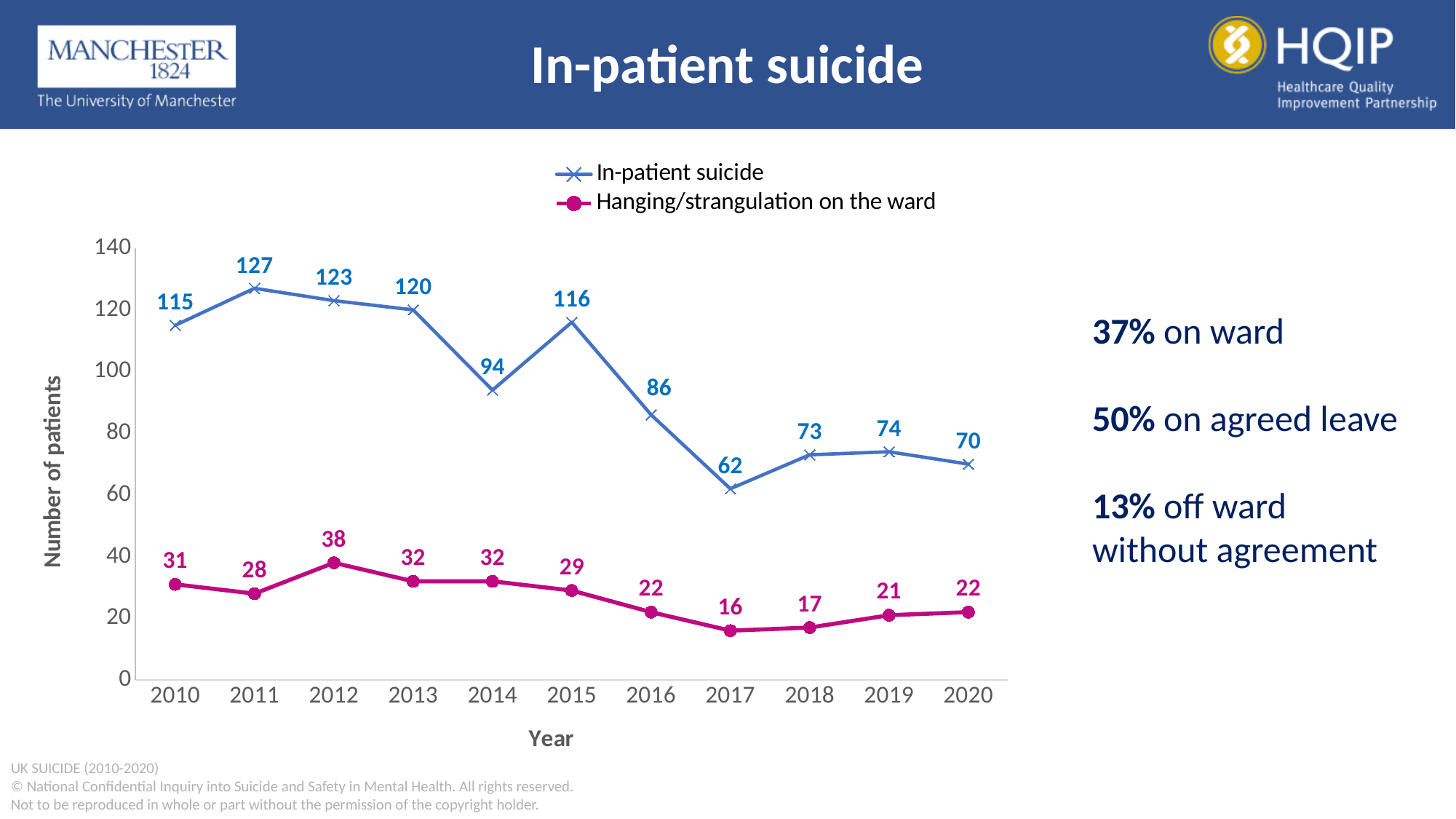
How many years are shown on the x axis? 11 What kind of chart is shown on the slide? line chart What is the value for Hanging/strangulation on the ward in 2017? 16 What is the difference between In-patient suicide in 2010 and in 2020? 45 Which is larger: Hanging/strangulation on the ward in 2012 or in 2019? 2012 Does the In-patient suicide series generally rise or fall from 2011 to 2017? fall Is the value for In-patient suicide in 2014 greater or less than 100? less In which year is the Hanging/strangulation on the ward series lowest? 2017 What is the label of the y axis? Number of patients How many series does the legend list? 2 In which year is the In-patient suicide series highest? 2011 What is the value for In-patient suicide in 2011? 127